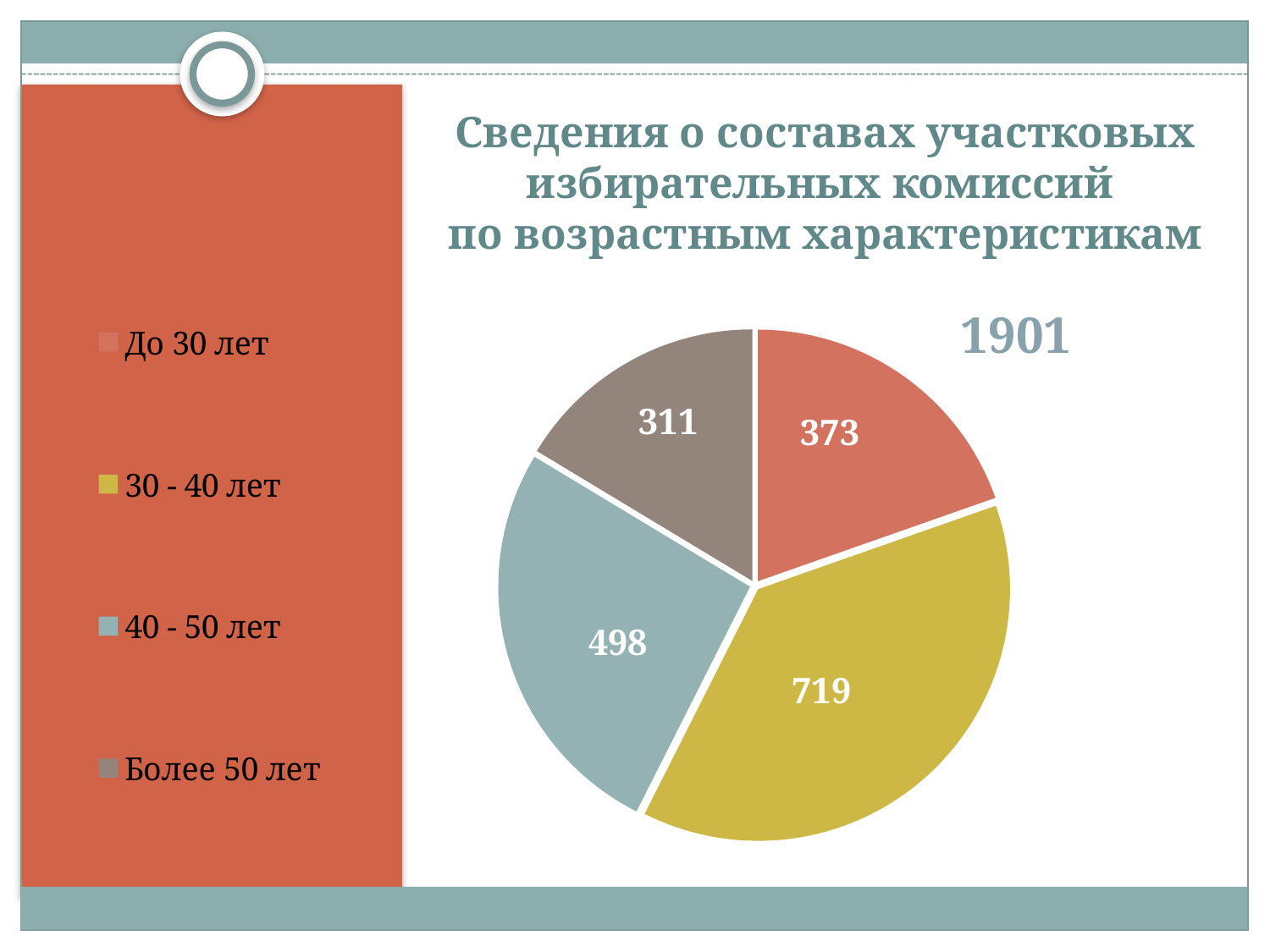
What is the difference between the values for "30 - 40 лет" and "40 - 50 лет"? 221 Which age group has the largest slice of the pie? 30 - 40 лет Which age group has the smallest slice of the pie? Более 50 лет What is the value for the "Более 50 лет" slice? 311 What kind of chart is shown on the slide? Pie chart How many slices does the pie chart have? 4 What colour is the "40 - 50 лет" slice in the pie chart? Teal (blue-grey) What is the value for the "До 30 лет" slice? 373 Which is larger, the value for "До 30 лет" or the value for "Более 50 лет"? До 30 лет What total number is printed next to the pie chart? 1901 What is the value for the "30 - 40 лет" slice? 719 What is the value for the "40 - 50 лет" slice? 498